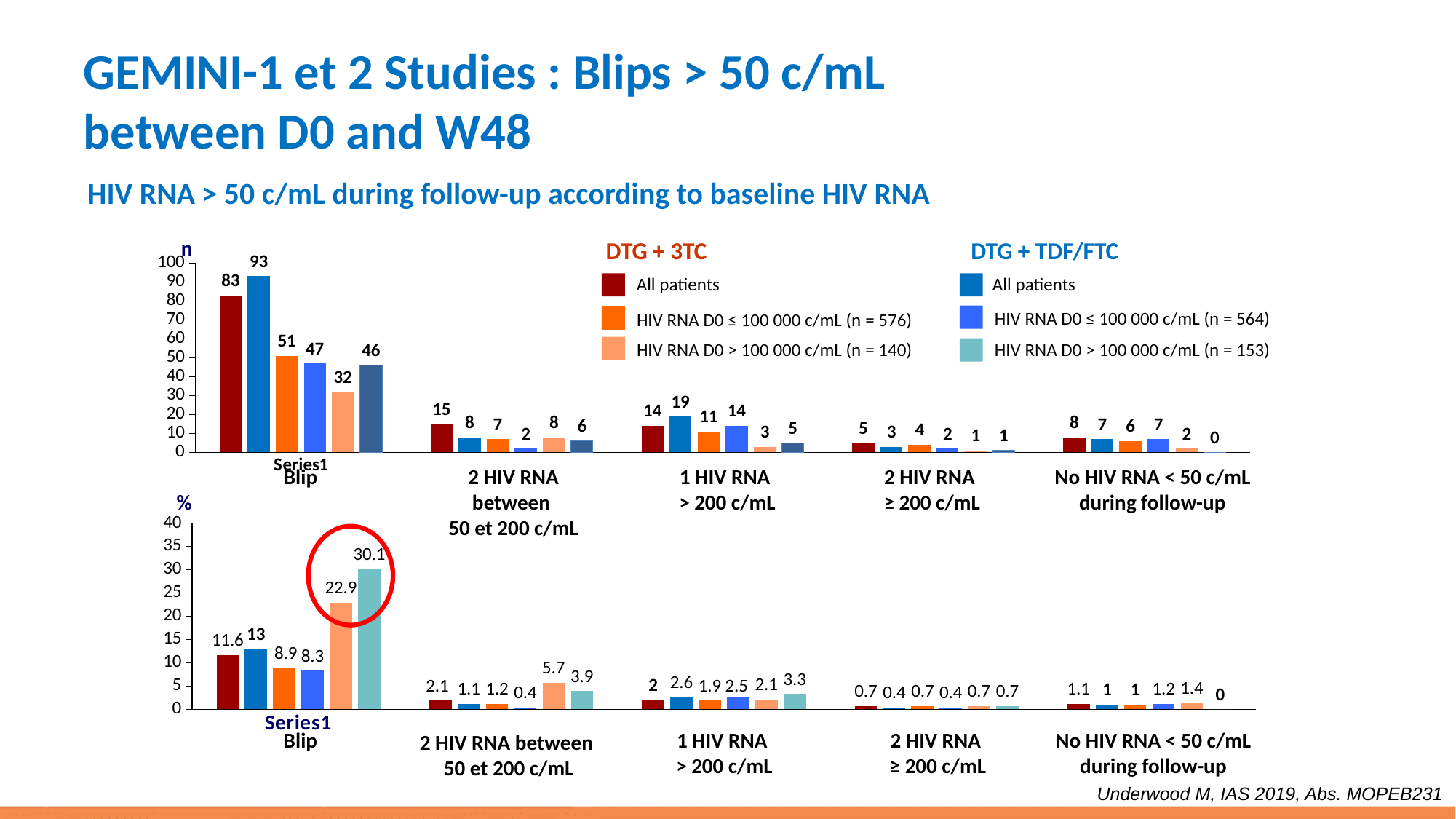
In the top chart (n), what is the difference between DTG + TDF/FTC All patients and DTG + 3TC All patients in the Blip category? 10 In the bottom chart (%), what is the value for DTG + 3TC HIV RNA D0 > 100 000 c/mL in the '2 HIV RNA between 50 et 200 c/mL' category? 5.7 In the top chart (n), what is the value for DTG + TDF/FTC HIV RNA D0 > 100 000 c/mL in the 'No HIV RNA < 50 c/mL during follow-up' category? 0 How many categories are shown on the x axis of the bottom chart (%)? 5 In the top chart (n), which category has the highest value for DTG + 3TC All patients? Blip In the bottom chart (%), what is the value for DTG + TDF/FTC HIV RNA D0 > 100 000 c/mL in the Blip category? 30.1 In the top chart (n), what is the value for DTG + 3TC All patients in the Blip category? 83 What type of chart is the top chart (n)? Bar chart In the bottom chart (%), what is the value for DTG + 3TC HIV RNA D0 > 100 000 c/mL in the Blip category? 22.9 How many series does the legend list in total? 6 In the bottom chart (%), which is larger in the Blip category: DTG + 3TC HIV RNA D0 > 100 000 c/mL or DTG + TDF/FTC HIV RNA D0 > 100 000 c/mL? DTG + TDF/FTC HIV RNA D0 > 100 000 c/mL In the top chart (n), what is the value for DTG + TDF/FTC All patients in the Blip category? 93